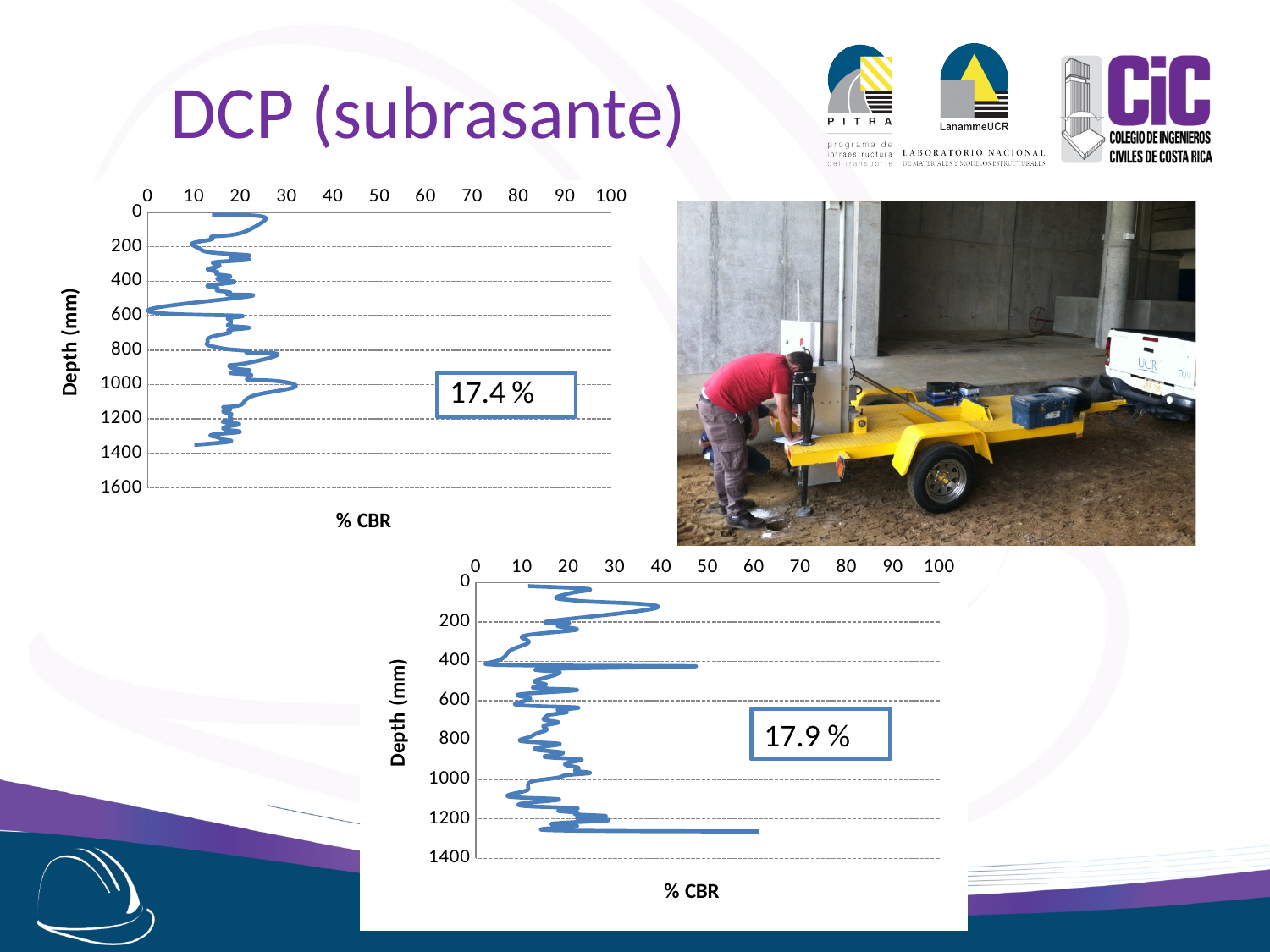
What is the difference between the annotated values on the bottom chart (17.9 %) and the top-left chart (17.4 %)? 0.5 % On the bottom chart, is the highest % CBR value reached by the line greater or less than 50? greater What value is printed in the annotation box on the top-left chart? 17.4 % Which chart shows the higher annotated % CBR value, the top-left chart or the bottom chart? bottom chart What is the largest depth value shown on the y axis of the top-left chart? 1600 What value is printed in the annotation box on the bottom chart? 17.9 % On the top-left chart, is the highest % CBR value reached by the line greater or less than 50? less What is the x-axis title of the bottom chart? % CBR What kind of chart is the top-left chart on the slide? line chart On the top-left chart, is the % CBR value at a depth of 1000 mm greater or less than 20? greater